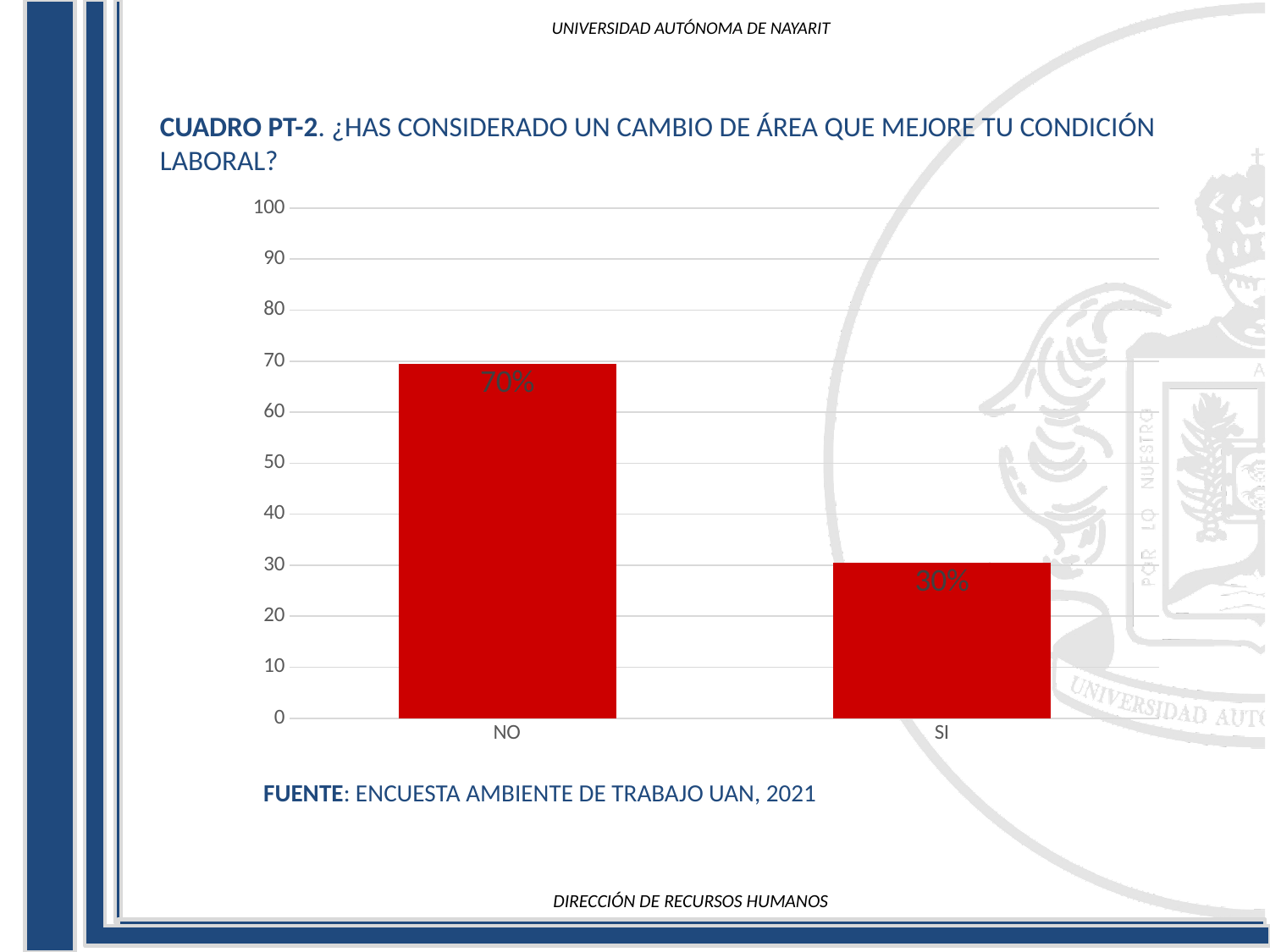
What kind of chart is shown on the slide? bar chart Which category has the highest value? NO What is the value for NO? 70% Is the value for NO greater or less than 50? greater What is the value for SI? 30% How many categories are shown on the x axis? 2 Which category has the lowest value? SI Is the value for SI greater or less than 40? less What is the source cited below the chart? ENCUESTA AMBIENTE DE TRABAJO UAN, 2021 What colour are the bars in the chart? red Which is larger, the value for NO or the value for SI? NO What is the difference between the values for NO and SI? 40%